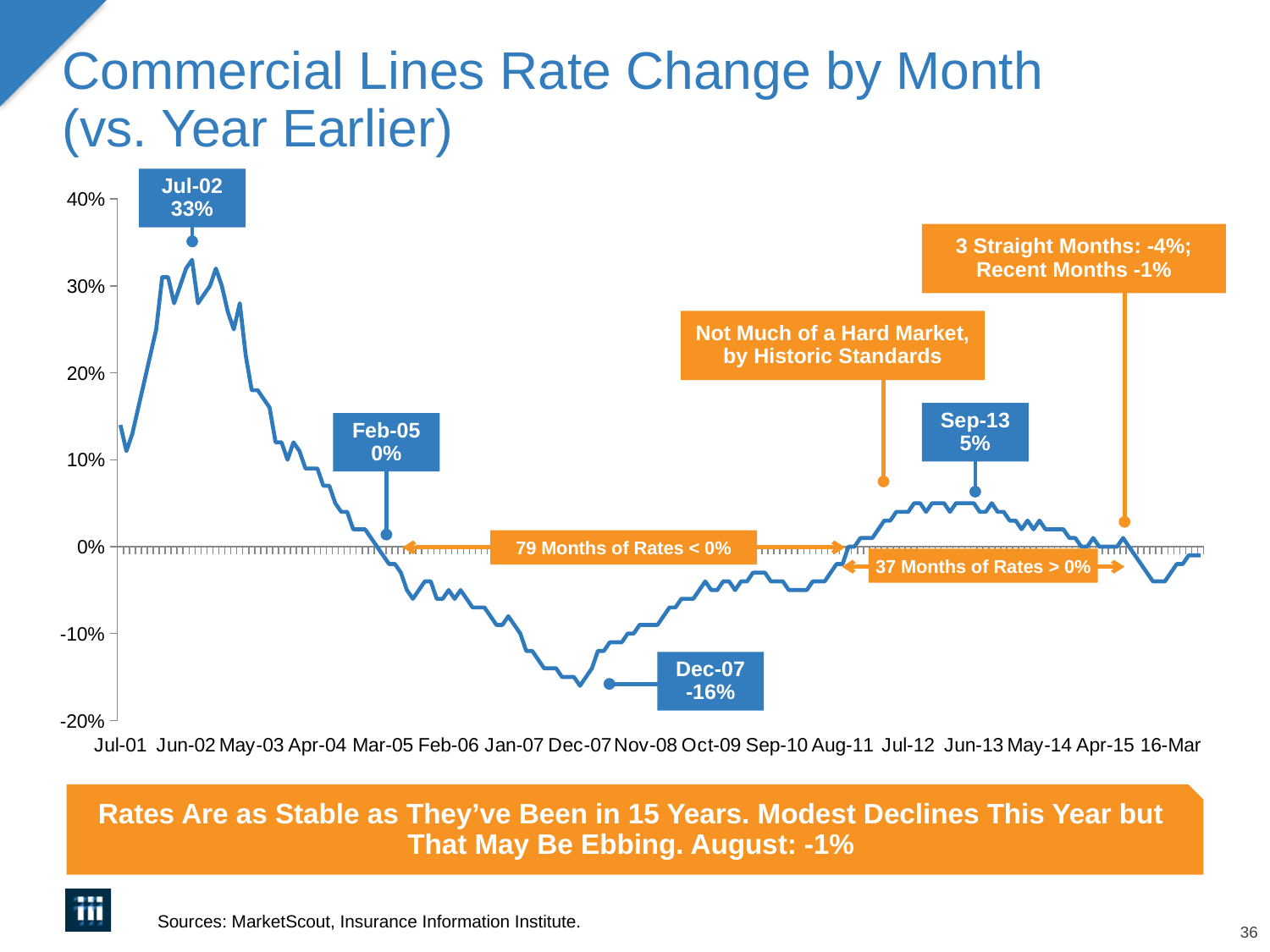
Does the rate change rise or fall between Jul-02 and Dec-07? Fall What was the commercial lines rate change in Dec-07? -16% According to the chart annotation, for how many months were rates below 0%? 79 months Which labeled month has the lowest rate change on the chart? Dec-07 What type of chart is shown on the slide? Line chart What was the commercial lines rate change in Feb-05? 0% Is the value for Jan-07 greater or less than 0%? less What is the difference in percentage points between the Jul-02 peak and the Dec-07 trough? 49 percentage points What was the commercial lines rate change in Jul-02? 33% Which is larger, the rate change in Jul-02 or in Sep-13? Jul-02 Which labeled month has the highest rate change on the chart? Jul-02 What was the commercial lines rate change in Sep-13? 5%